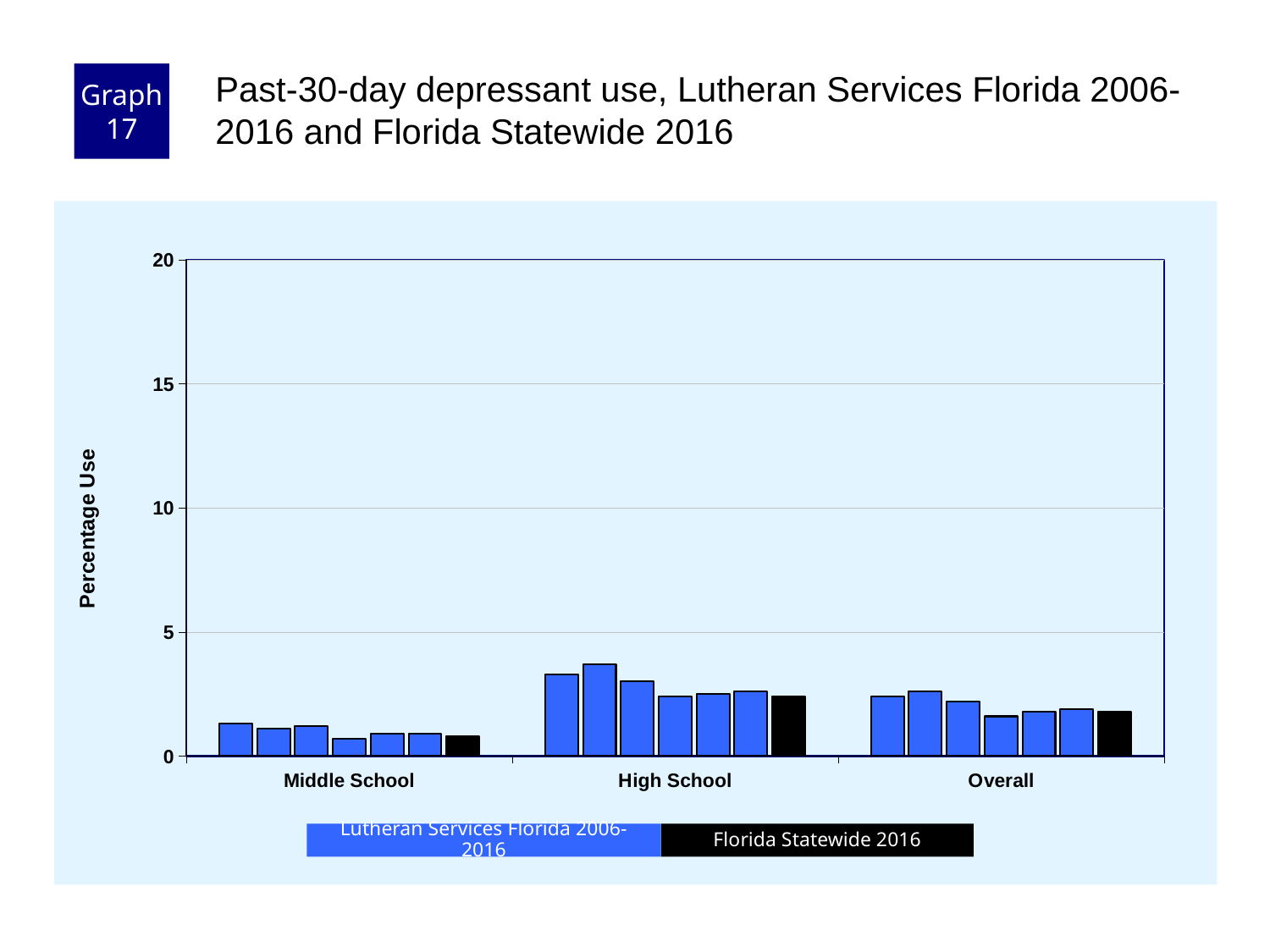
Is the Florida Statewide 2016 value for Overall greater or less than 10? less Which category has the lowest bars in the chart? Middle School Which category has the tallest bars in the chart? High School Which is larger, the Florida Statewide 2016 value for High School or for Middle School? High School What colour represents Florida Statewide 2016 in the chart? black Are any of the bars in the chart greater than 5? No How many categories are shown on the x axis of the chart? 3 How many series does the chart's legend list? 2 Is the Florida Statewide 2016 value for Middle School greater or less than 5? less What kind of chart is shown on the slide? bar chart What is the label on the y axis of the chart? Percentage Use